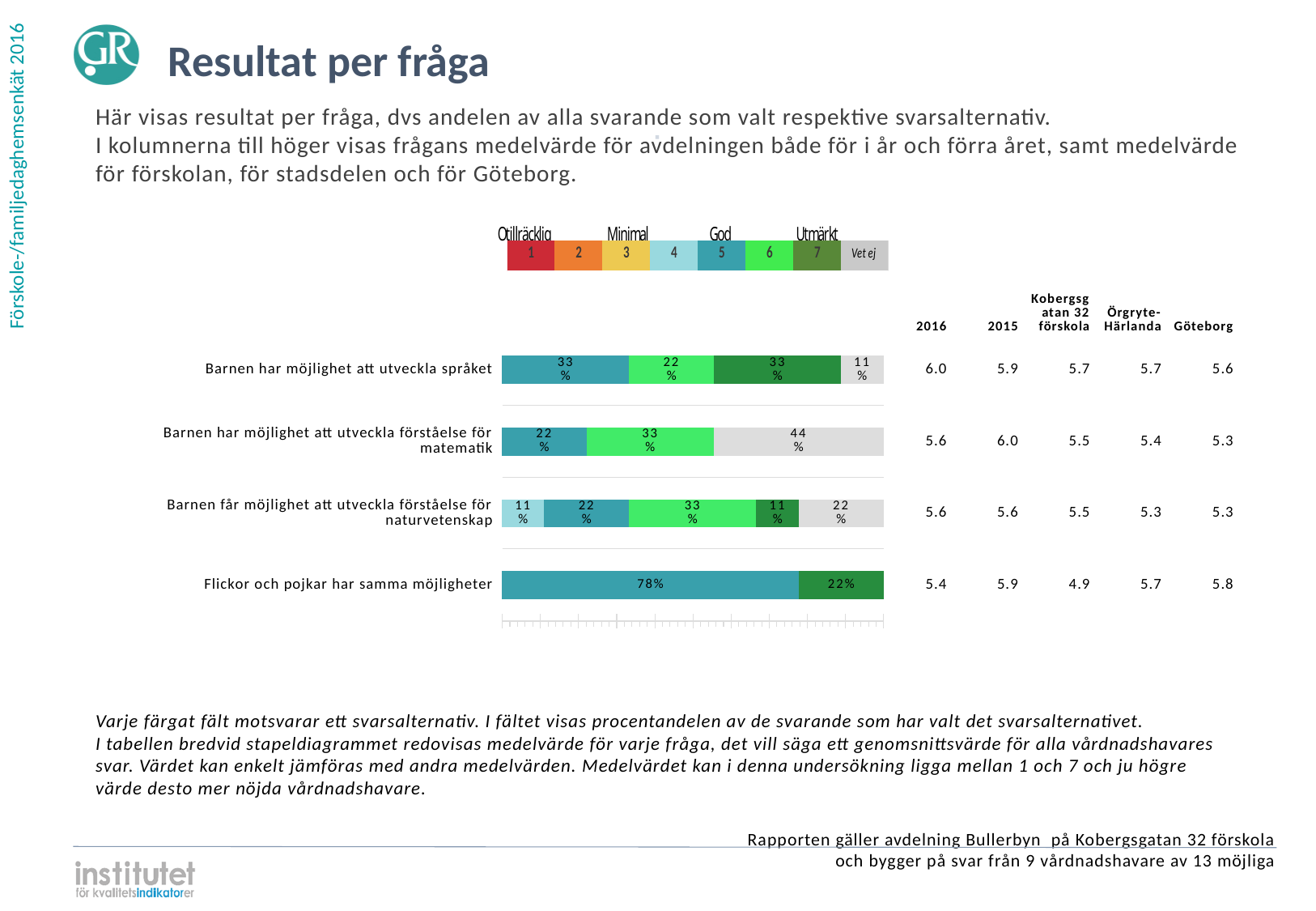
What is the 2016 mean value shown for 'Barnen har möjlighet att utveckla språket'? 6.0 How many questions (categories) are plotted in the bar chart? 4 What kind of chart is shown on the slide? stacked bar chart Which is larger for 'Barnen har möjlighet att utveckla förståelse för matematik': the 'Vet ej' segment or the light green (6) segment? Vet ej What percentage is shown for the light blue (4) segment of 'Barnen får möjlighet att utveckla förståelse för naturvetenskap'? 11% What percentage is shown for the teal (5) segment of 'Flickor och pojkar har samma möjligheter'? 78% What percentage of respondents chose 'Vet ej' for 'Barnen har möjlighet att utveckla förståelse för matematik'? 44% Which question has the largest single segment in its bar? Flickor och pojkar har samma möjligheter What is the difference between the 78% and 22% segments in the bar for 'Flickor och pojkar har samma möjligheter'? 56% What percentage is shown for the dark green (7) segment of 'Barnen har möjlighet att utveckla språket'? 33% What is the Göteborg mean value shown for 'Flickor och pojkar har samma möjligheter'? 5.8 How many response options does the legend above the chart list, including 'Vet ej'? 8